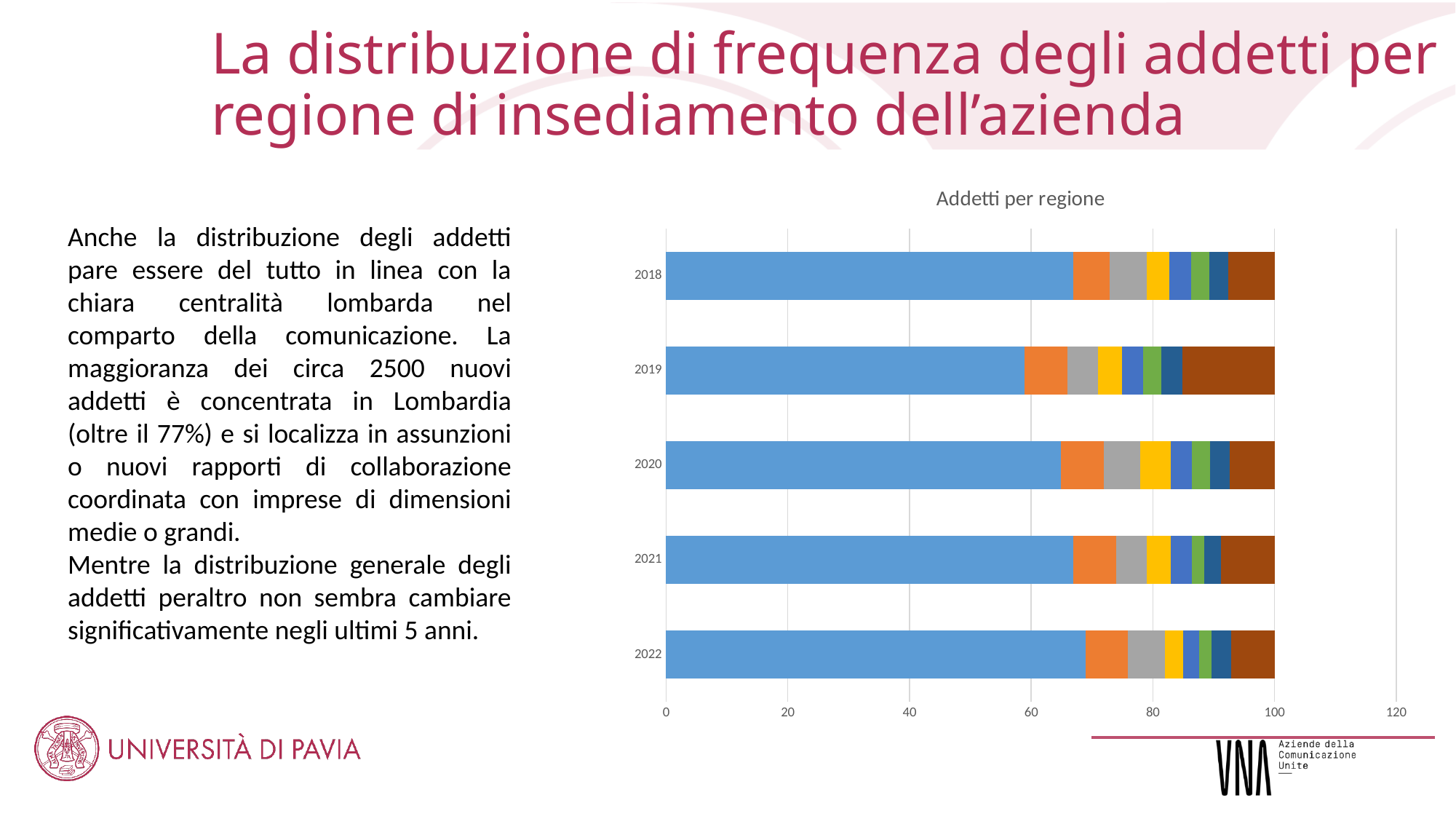
Is the blue segment for 2019 greater or less than 40? greater Which is larger, the brown segment for 2018 or the brown segment for 2019? 2019 What is the title of the chart? Addetti per regione How many years (categories) are shown on the chart? 5 What kind of chart is shown on the slide? stacked bar chart What is the total value of the stacked bar for 2018? 100 What is the highest value shown on the horizontal axis? 120 Is the blue segment for 2018 greater or less than 80? less Which year has the largest brown (last) segment? 2019 Which is larger, the blue segment for 2019 or the blue segment for 2022? 2022 Which year has the smallest blue (first) segment? 2019 Is the blue segment for 2022 greater or less than 60? greater